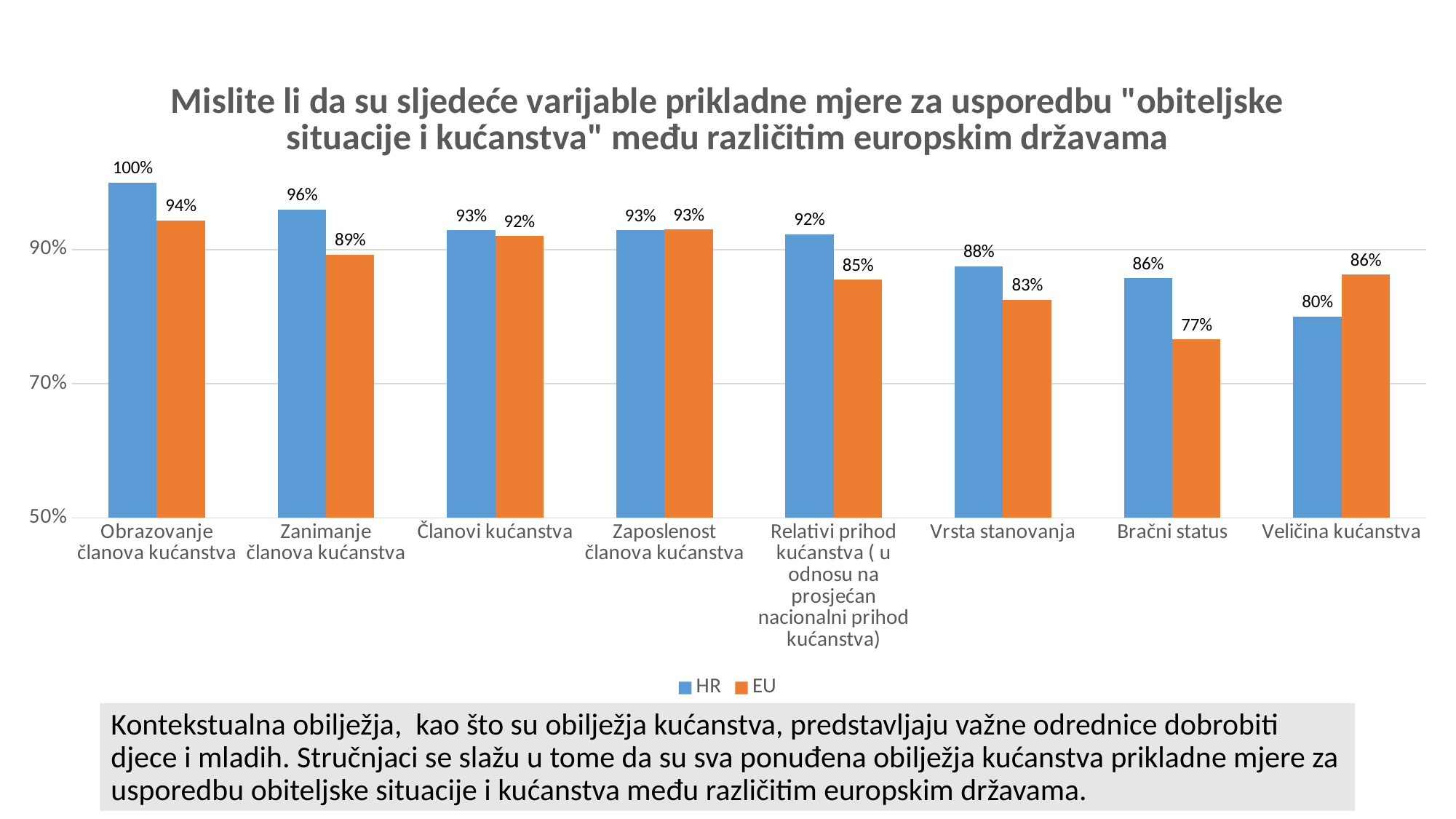
How many series does the legend list? 2 Which category has the highest EU value? Obrazovanje članova kućanstva What kind of chart is shown on the slide? bar chart Which category has the lowest HR value? Veličina kućanstva Is the EU value for Vrsta stanovanja greater or less than 90%? less What is the difference between the HR and EU values for Bračni status? 9% What is the EU value for Veličina kućanstva? 86% What is the HR value for Obrazovanje članova kućanstva? 100% What is the EU value for Bračni status? 77% What is the difference between the HR and EU values for Zanimanje članova kućanstva? 7% Which is larger for Veličina kućanstva, the HR value or the EU value? EU How many categories are shown on the x axis? 8